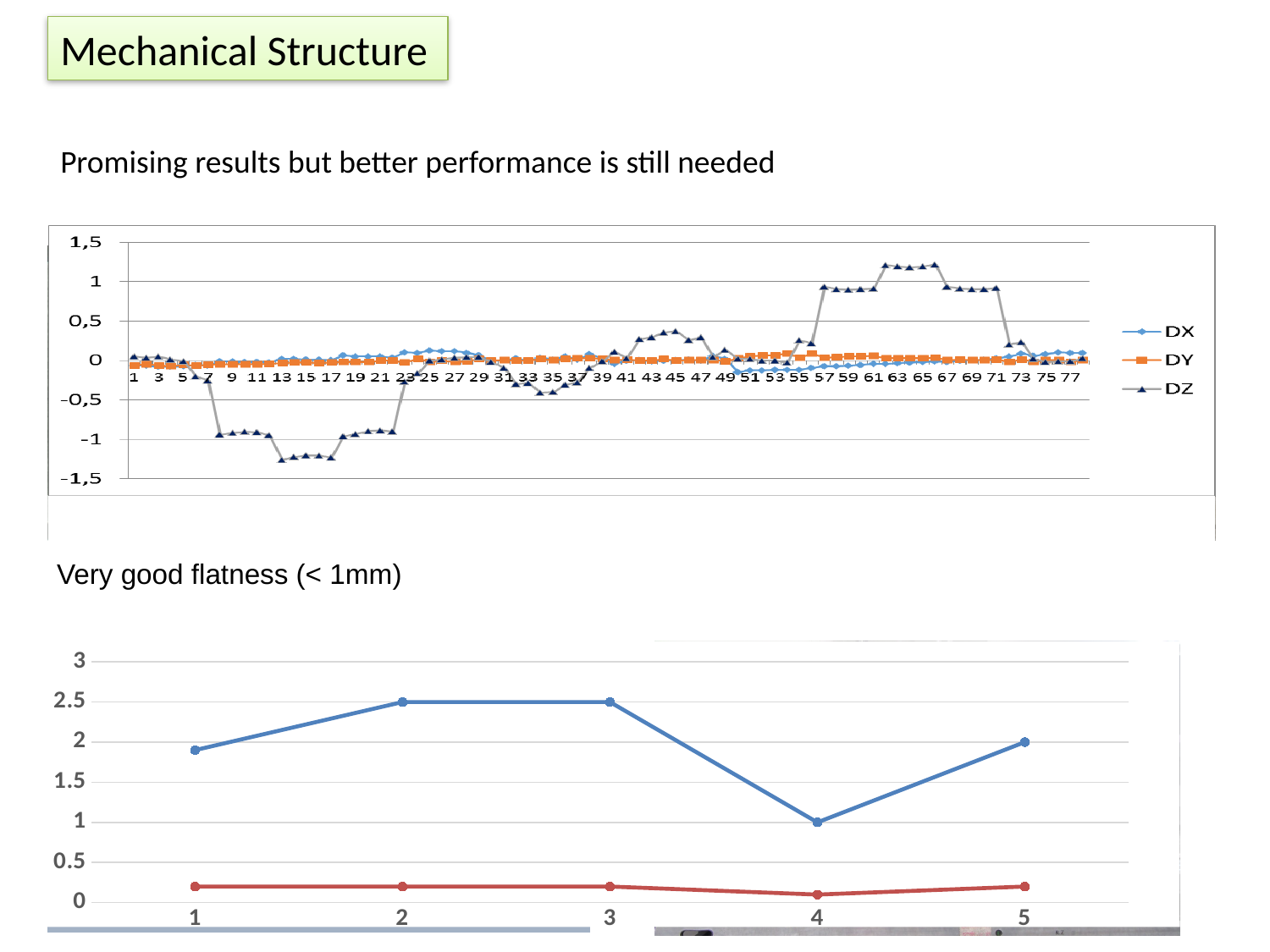
In the bottom chart, at which x value does the blue line reach its lowest point? 4 What kind of chart is the bottom chart on the slide? line chart In the bottom chart, is the blue line's value at x = 1 greater or less than 1.5? greater In the top chart, how many series does the legend list? 3 In the top chart, is the DZ value at x = 57 greater or less than 0.5? greater In the bottom chart, how many points are plotted along the x axis for each line? 5 In the top chart, which series has the largest swings away from zero? DZ In the bottom chart, does the blue line rise or fall between x = 3 and x = 4? fall In the top chart, what are the names of the series in the legend? DX, DY, DZ What kind of chart is the top chart on the slide? line chart In the top chart, is the DZ value at x = 65 greater or less than 1? greater